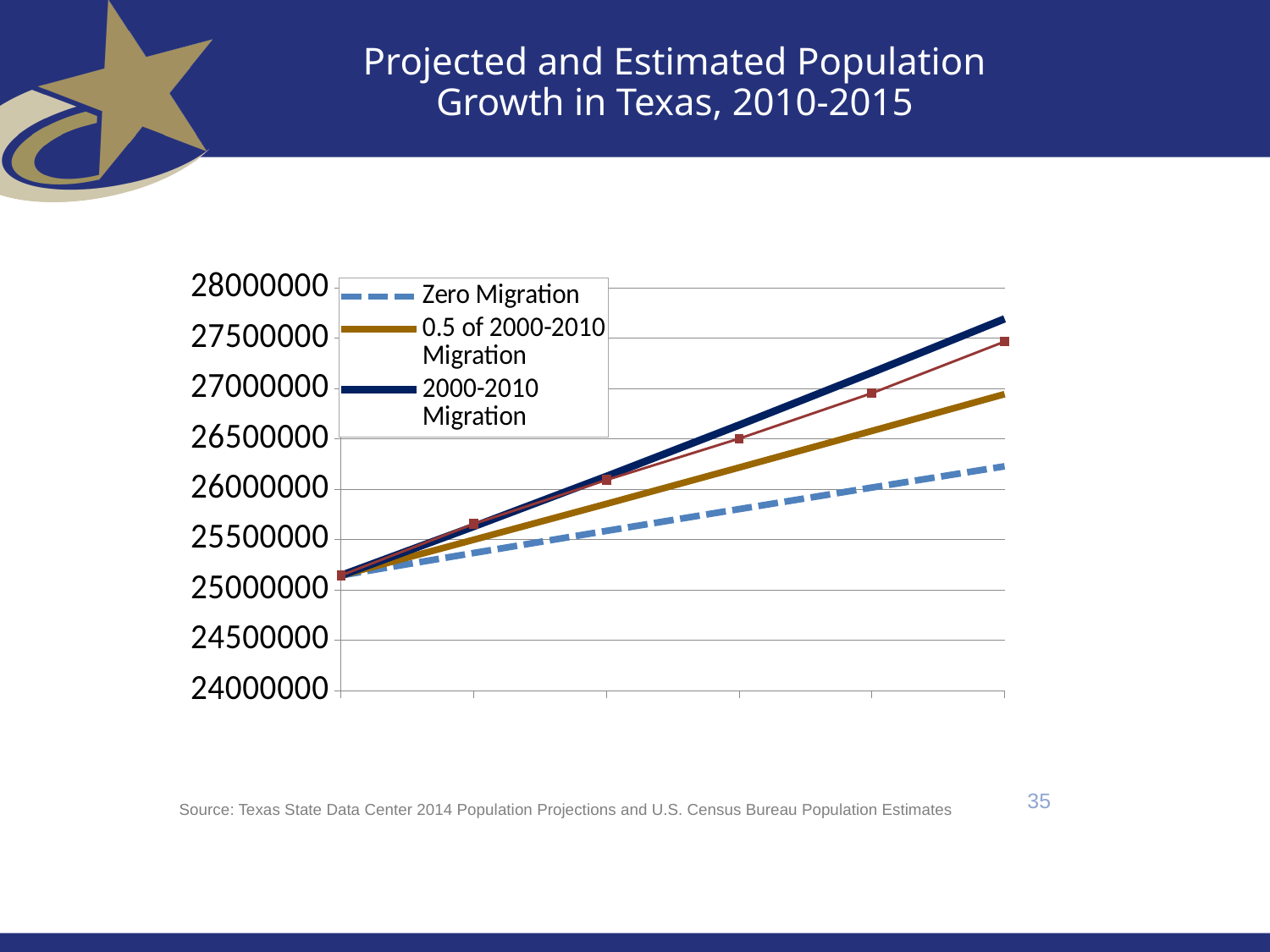
What kind of chart is shown on the slide? line chart Which series has the lowest value at the right end of the chart? Zero Migration Which series reaches the highest value at the right end of the chart? 2000-2010 Migration Is the value for 2000-2010 Migration at the right end of the chart greater or less than 27500000? greater Do the values for the 2000-2010 Migration series rise or fall along the x axis? rise How many series does the legend list? 3 Is the value for 0.5 of 2000-2010 Migration at the right end of the chart greater or less than 26500000? greater Is the value for Zero Migration at the right end of the chart greater or less than 26500000? less Which legend entry is drawn as a dashed line? Zero Migration Do the values for the Zero Migration series rise or fall along the x axis? rise At the right end of the chart, which is larger: the Zero Migration value or the 2000-2010 Migration value? 2000-2010 Migration What is the title of the chart? Projected and Estimated Population Growth in Texas, 2010-2015